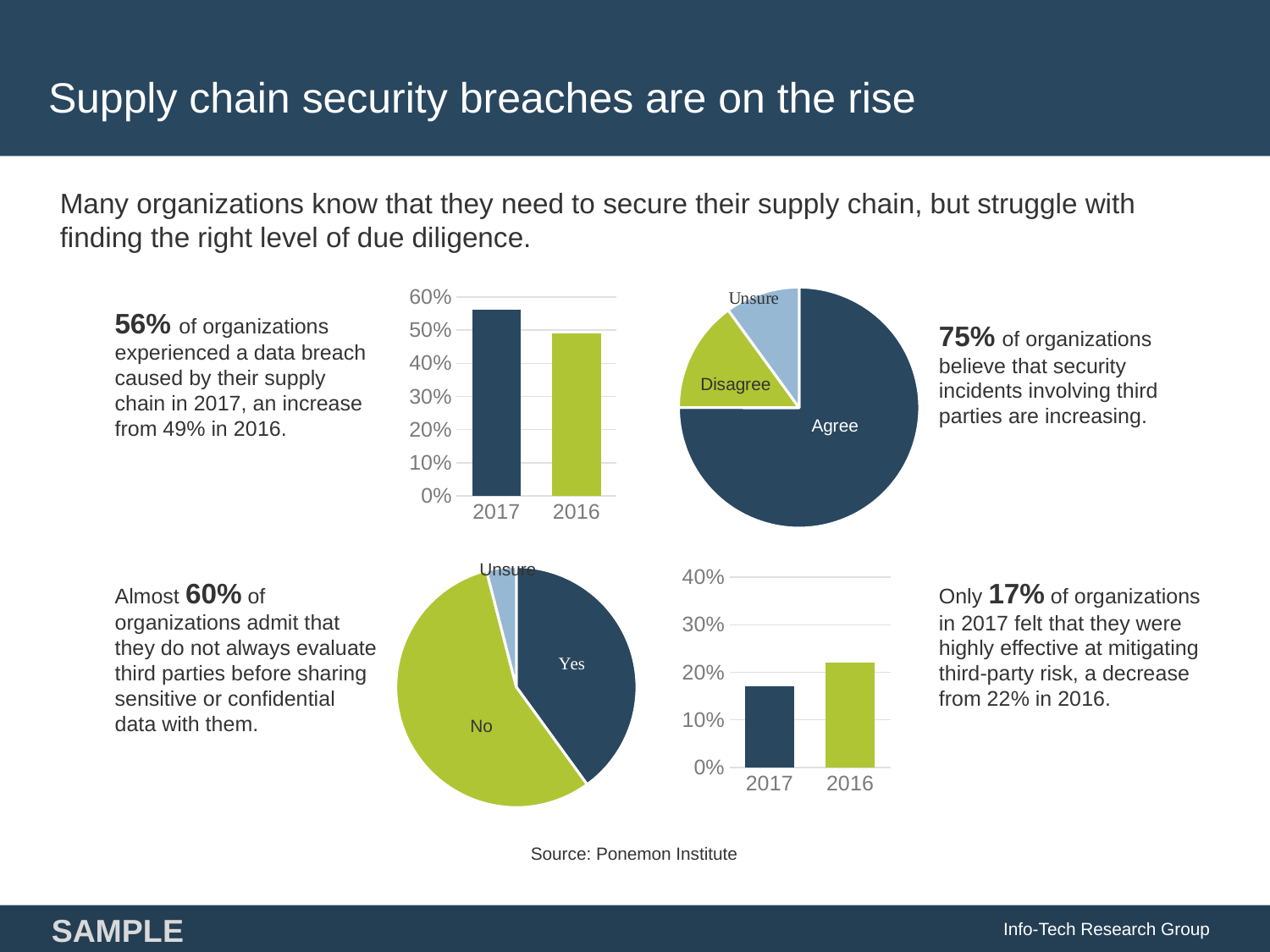
In the bottom-left pie chart, which slice is the largest? No In the top-left bar chart, is the value for 2017 greater or less than 50%? greater In the bottom-right bar chart, which bar is taller, 2017 or 2016? 2016 In the top-left bar chart, which bar is taller, 2017 or 2016? 2017 In the top-right pie chart, which slice is the largest? Agree In the top-left bar chart, is the value for 2016 greater or less than 50%? less In the top-right pie chart, how many slices are there? 3 In the top-left bar chart, how many categories are shown on the x axis? 2 In the bottom-right bar chart, is the value for 2017 greater or less than 20%? less In the top-right pie chart, which slice is the smallest? Unsure What kind of chart is the top-right chart with the Agree, Disagree and Unsure slices? pie chart What kind of chart is the top-left chart with the 2017 and 2016 categories? bar chart